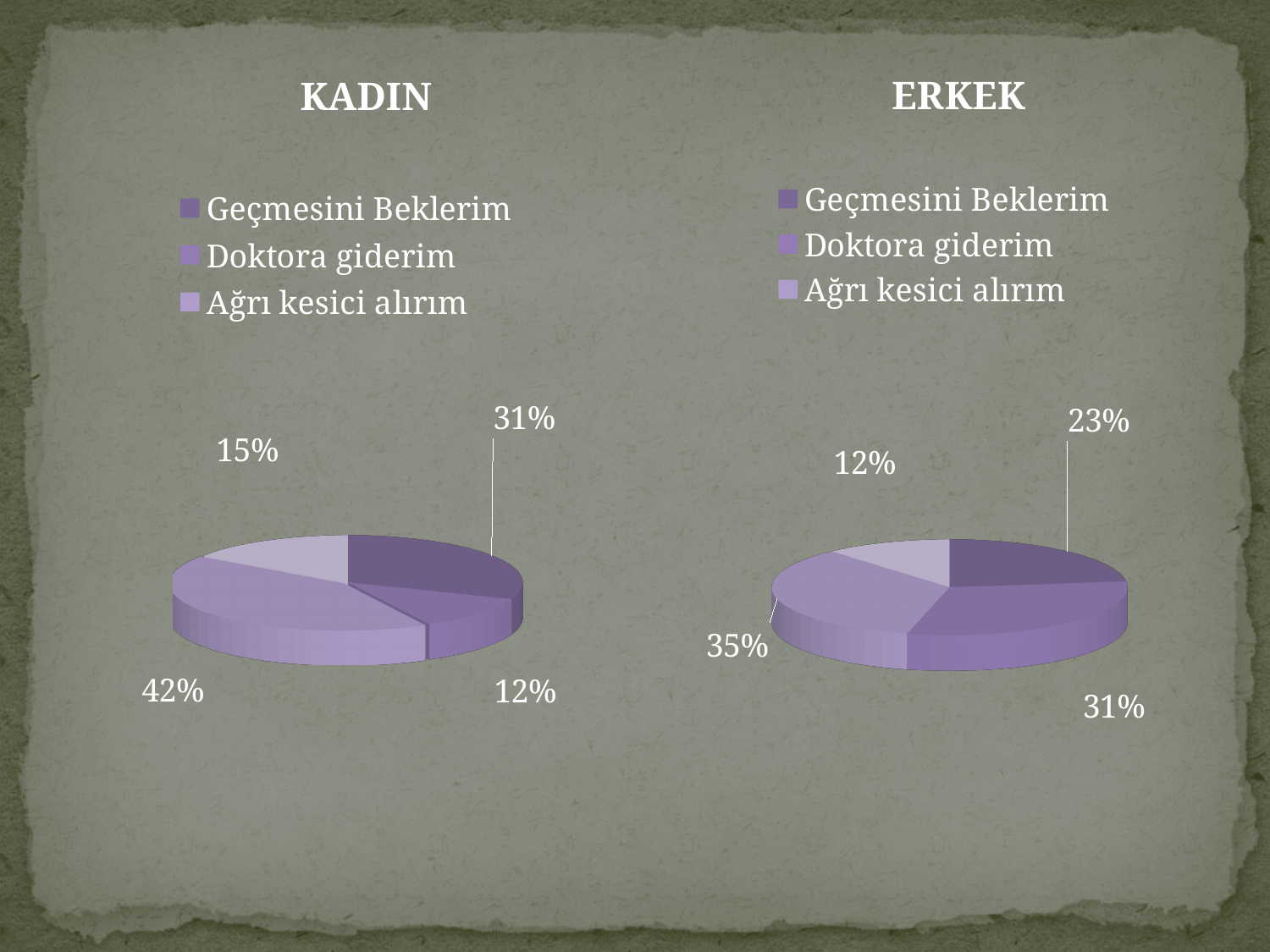
On the KADIN chart, what is the difference between the Ağrı kesici alırım slice and the Doktora giderim slice? 30% On the ERKEK chart, which is larger: Doktora giderim or Geçmesini Beklerim? Doktora giderim What kind of chart is the KADIN chart? Pie chart On the KADIN chart, what percentage is shown for Geçmesini Beklerim? 31% On the KADIN chart, which legend category has the largest slice? Ağrı kesici alırım On the KADIN chart, what percentage is shown for Doktora giderim? 12% How many entries does the legend of the ERKEK chart list? 3 On the KADIN chart, what percentage is shown for Ağrı kesici alırım? 42% On the ERKEK chart, what percentage is shown for Ağrı kesici alırım? 35% On the ERKEK chart, what percentage is shown for Geçmesini Beklerim? 23% On the ERKEK chart, which legend category has the largest slice? Ağrı kesici alırım On the ERKEK chart, what percentage is shown for Doktora giderim? 31%